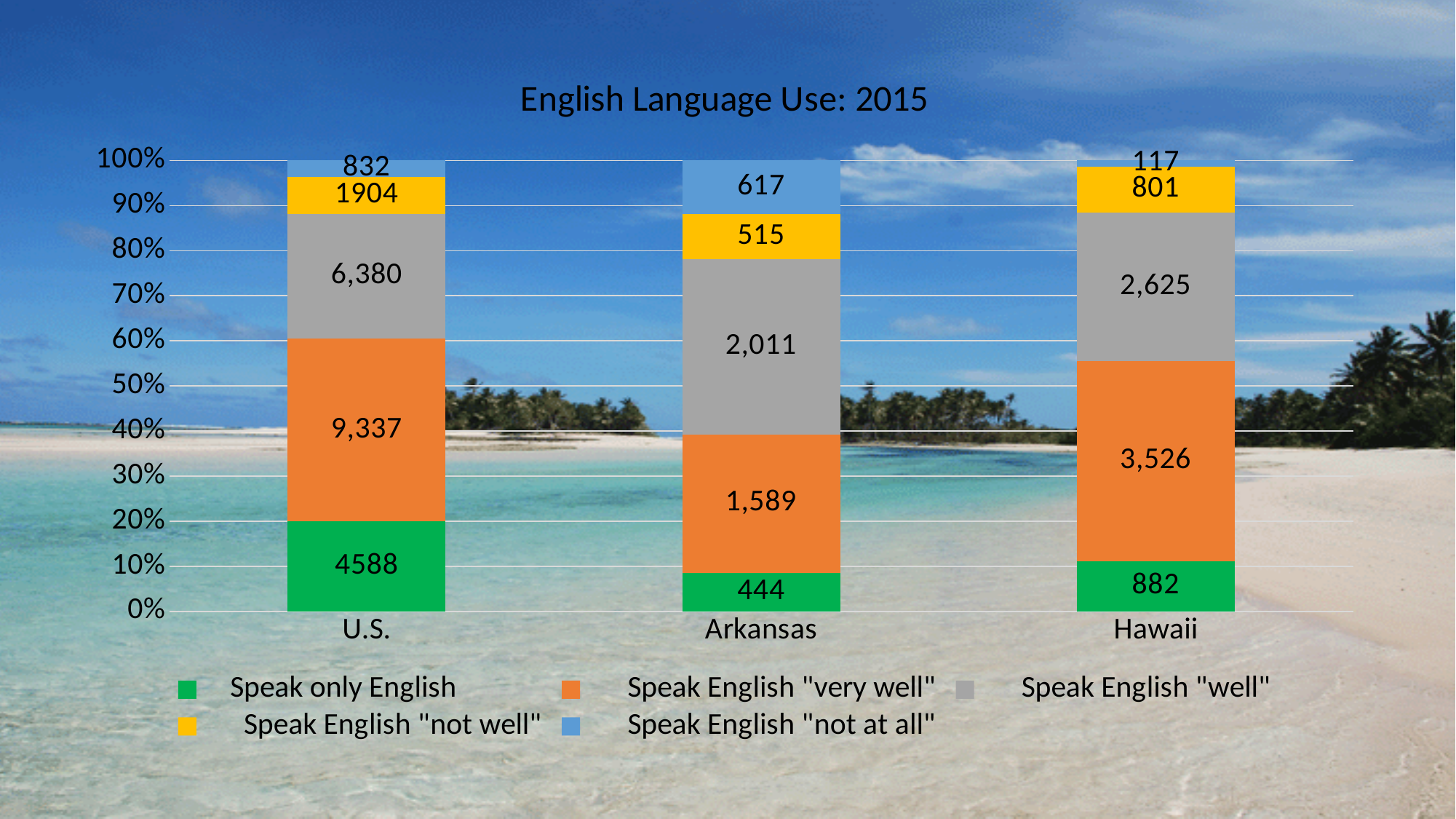
What is the value for "Speak English "not at all"" in the Hawaii bar? 117 In the U.S. bar, what is the difference between the "Speak English "very well"" value and the "Speak English "well"" value? 2,957 What kind of chart is shown on the slide? Stacked bar chart What is the total of all segments in the Hawaii bar? 7,951 What is the value for "Speak English "well"" in the Hawaii bar? 2,625 What is the value for "Speak English "very well"" in the U.S. bar? 9,337 Which category has the highest value for "Speak only English"? U.S. How many series does the legend list? 5 How many categories are shown on the x axis? 3 In the Arkansas bar, which is larger: "Speak English "well"" or "Speak English "very well""? Speak English "well" Which category has the lowest value for "Speak English "not at all""? Hawaii What is the value for "Speak only English" in the Arkansas bar? 444